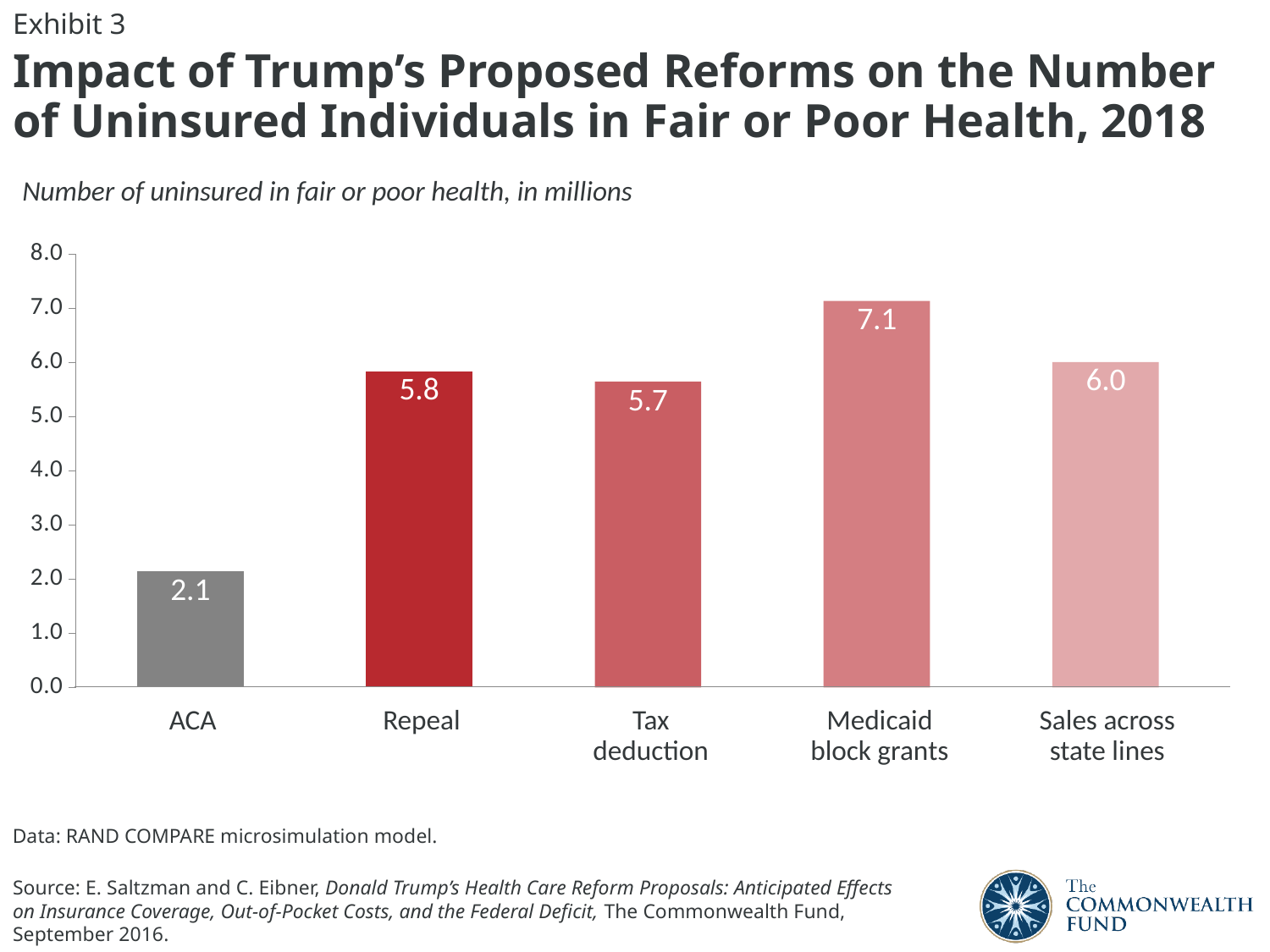
Which is larger, the value for Sales across state lines or the value for Repeal? Sales across state lines Is the value for Tax deduction greater or less than 5.0? greater Which category has the highest number of uninsured in fair or poor health? Medicaid block grants What is the difference between the values for Medicaid block grants and ACA? 5.0 What kind of chart is shown on the slide? Bar chart How many categories are shown on the chart? 5 What unit is the number of uninsured in fair or poor health expressed in, according to the chart subtitle? Millions Which category has the lowest number of uninsured in fair or poor health? ACA What is the value shown for Medicaid block grants? 7.1 What is the number of uninsured in fair or poor health (in millions) under the ACA? 2.1 What is the difference between the values for Repeal and Tax deduction? 0.1 What is the value shown for Sales across state lines? 6.0